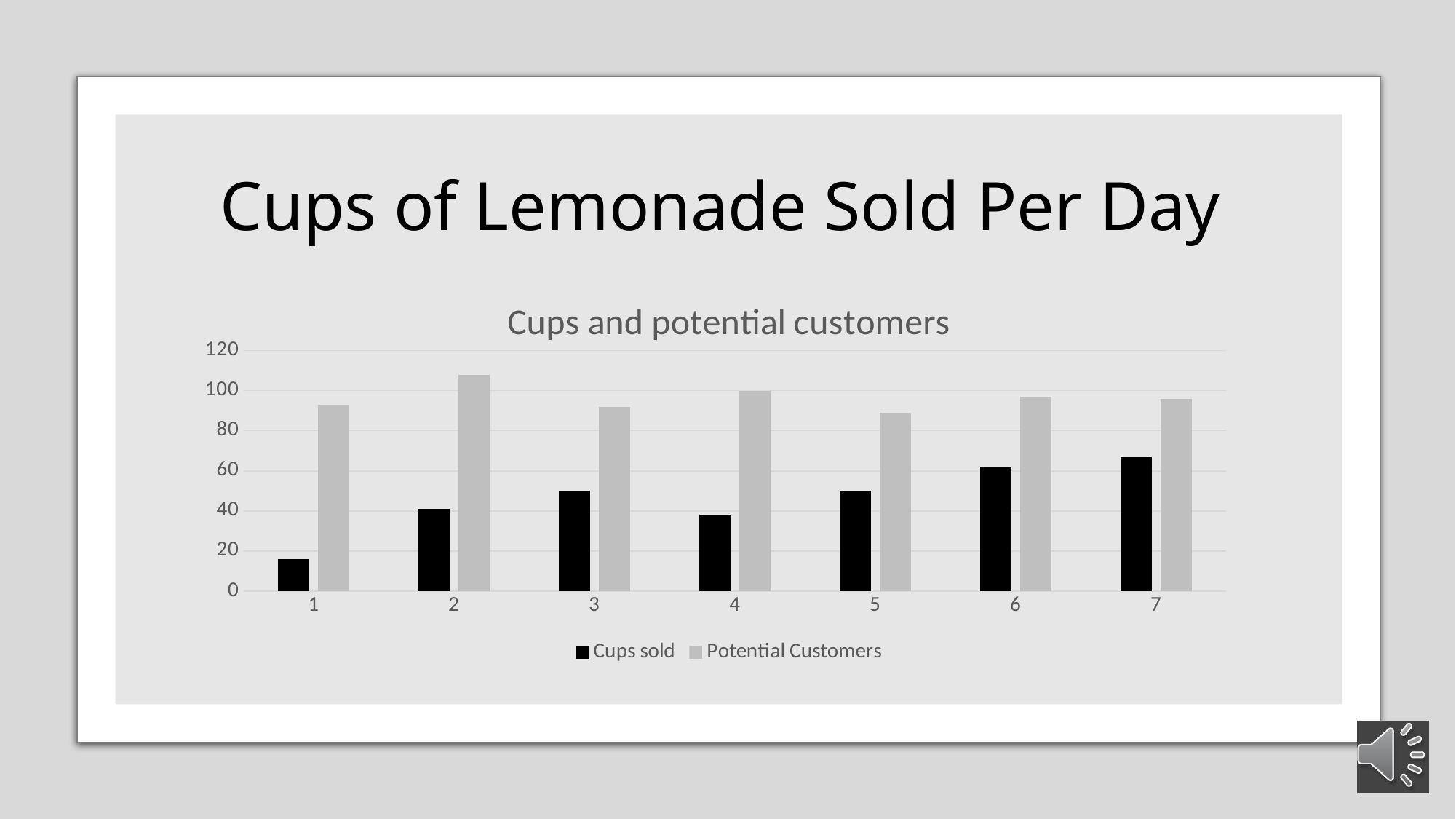
On which day is the value for Cups sold highest? 7 Is the value for Potential Customers on day 2 greater or less than 100? greater How many series does the legend list? 2 On which day is the value for Potential Customers highest? 2 Which series is drawn in black? Cups sold What is the title of the chart? Cups and potential customers What kind of chart is shown on the slide? bar chart Is the value for Cups sold on day 1 greater or less than 20? less On which day is the value for Cups sold lowest? 1 Is the value for Cups sold on day 7 greater or less than 60? greater On day 4, which is larger: Cups sold or Potential Customers? Potential Customers How many categories (days) are shown on the x axis? 7